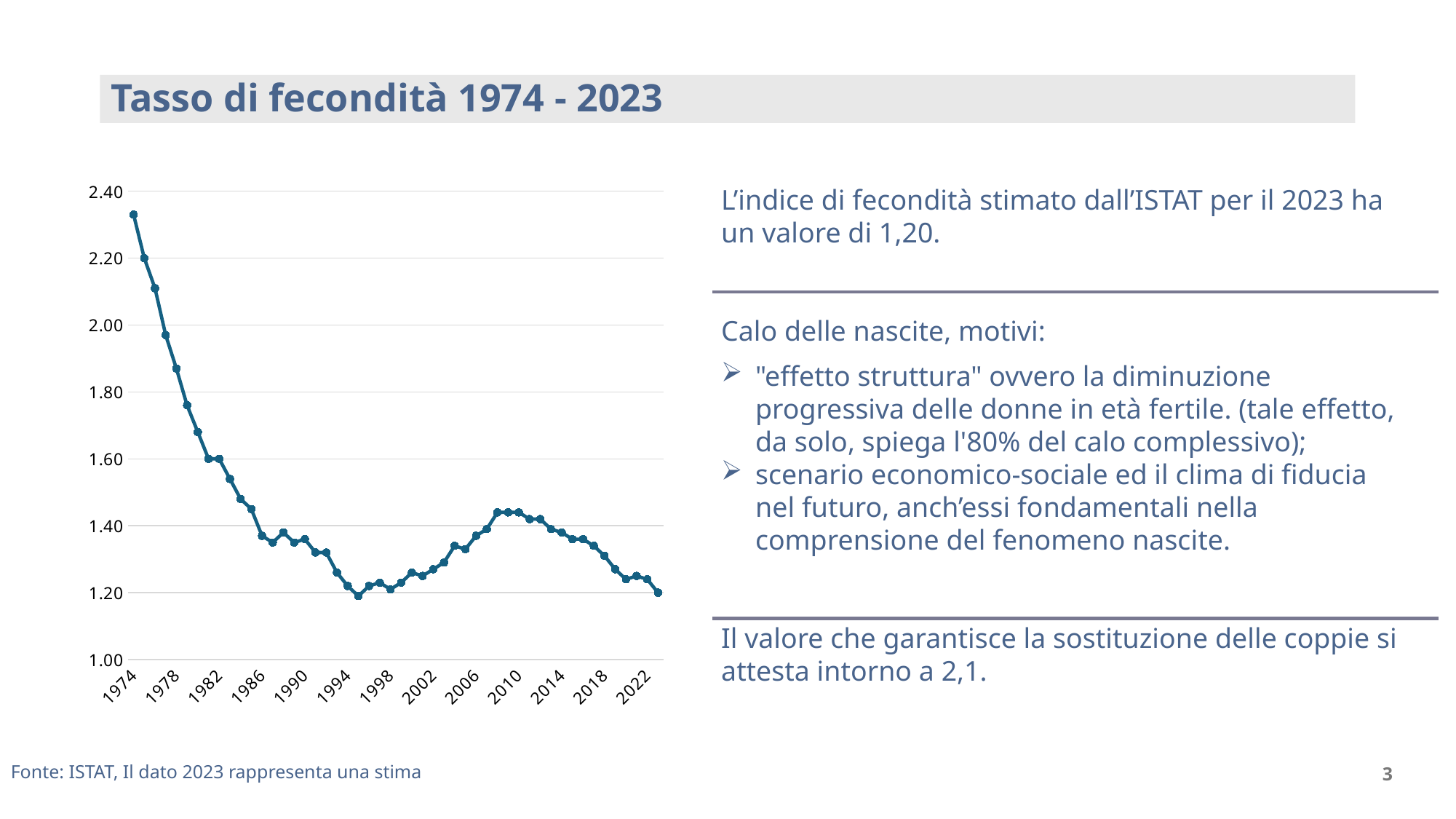
Is the value for 2002 greater or less than 1.40? less Do the values rise or fall between 1974 and 1994? fall What kind of chart is shown on the slide? line chart Do the values rise or fall between 2010 and 2023? fall Is the value for 1974 greater or less than 2.20? greater Which year has the larger value, 1982 or 2006? 1982 What is the value plotted for 2023? 1.20 Which year has the larger value, 1974 or 2023? 1974 Is the value for 1978 greater or less than 1.80? greater What is the title of the chart? Tasso di fecondità 1974 - 2023 In which year does the chart reach its highest value? 1974